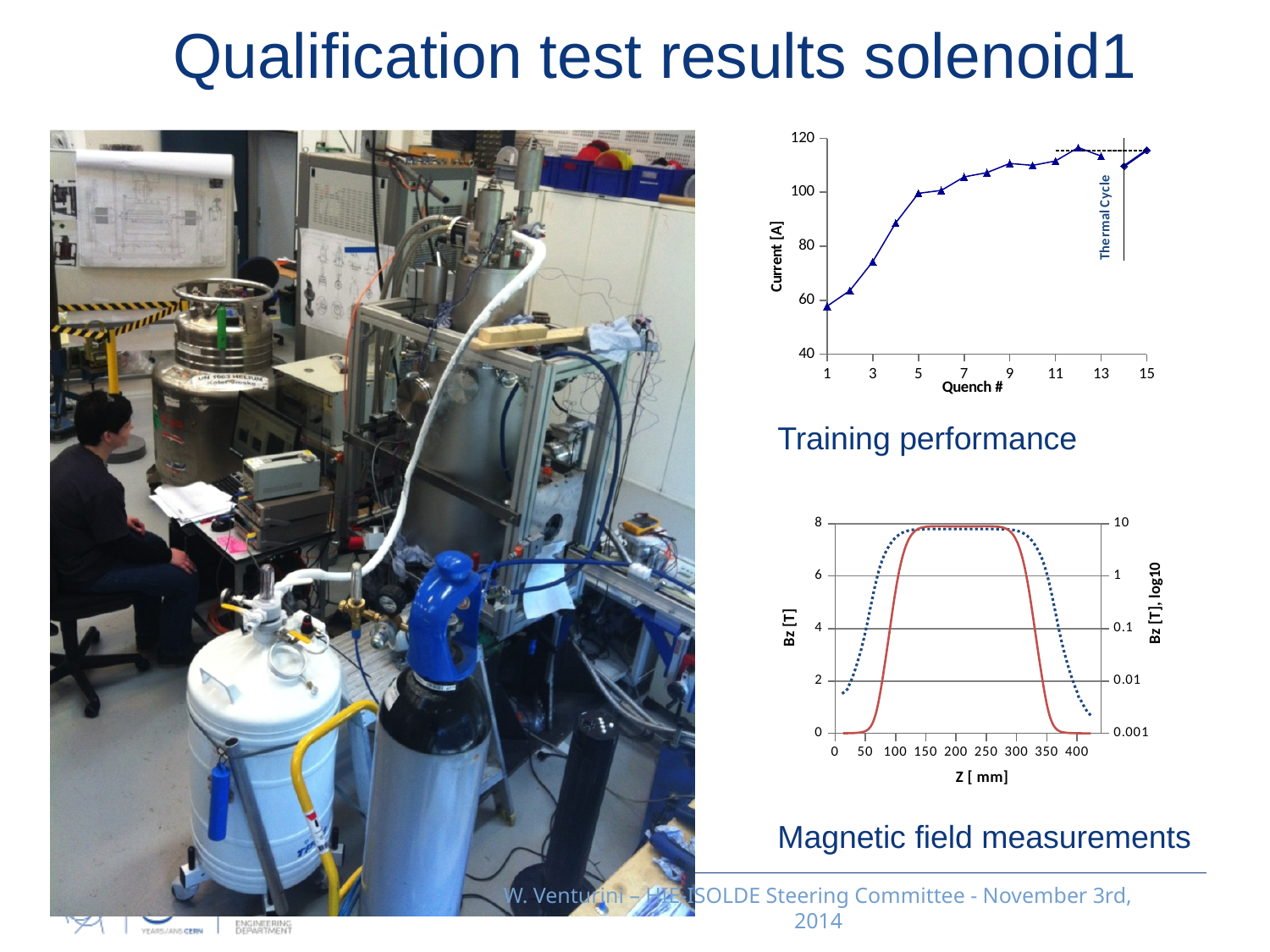
In the Magnetic field measurements chart, is the solid-line Bz value at Z = 200 mm greater or less than 6 T on the left axis? greater In the Training performance chart, how many quench data points are plotted? 15 In the Training performance chart, is the current at quench 12 greater or less than 100 A? greater In the Training performance chart, which quench number has the lowest current? 1 In the Magnetic field measurements chart, what is the label of the right-hand y axis? Bz [T], log10 What type of chart is the Training performance chart? line chart In the Training performance chart, is the current at quench 3 greater or less than 60 A? greater In the Training performance chart, does the current generally rise or fall as the quench number increases? rise In the Magnetic field measurements chart, how many lines are plotted? 2 In the Training performance chart, which has the higher current: quench 3 or quench 9? quench 9 In the Training performance chart, what is the label of the x axis? Quench #